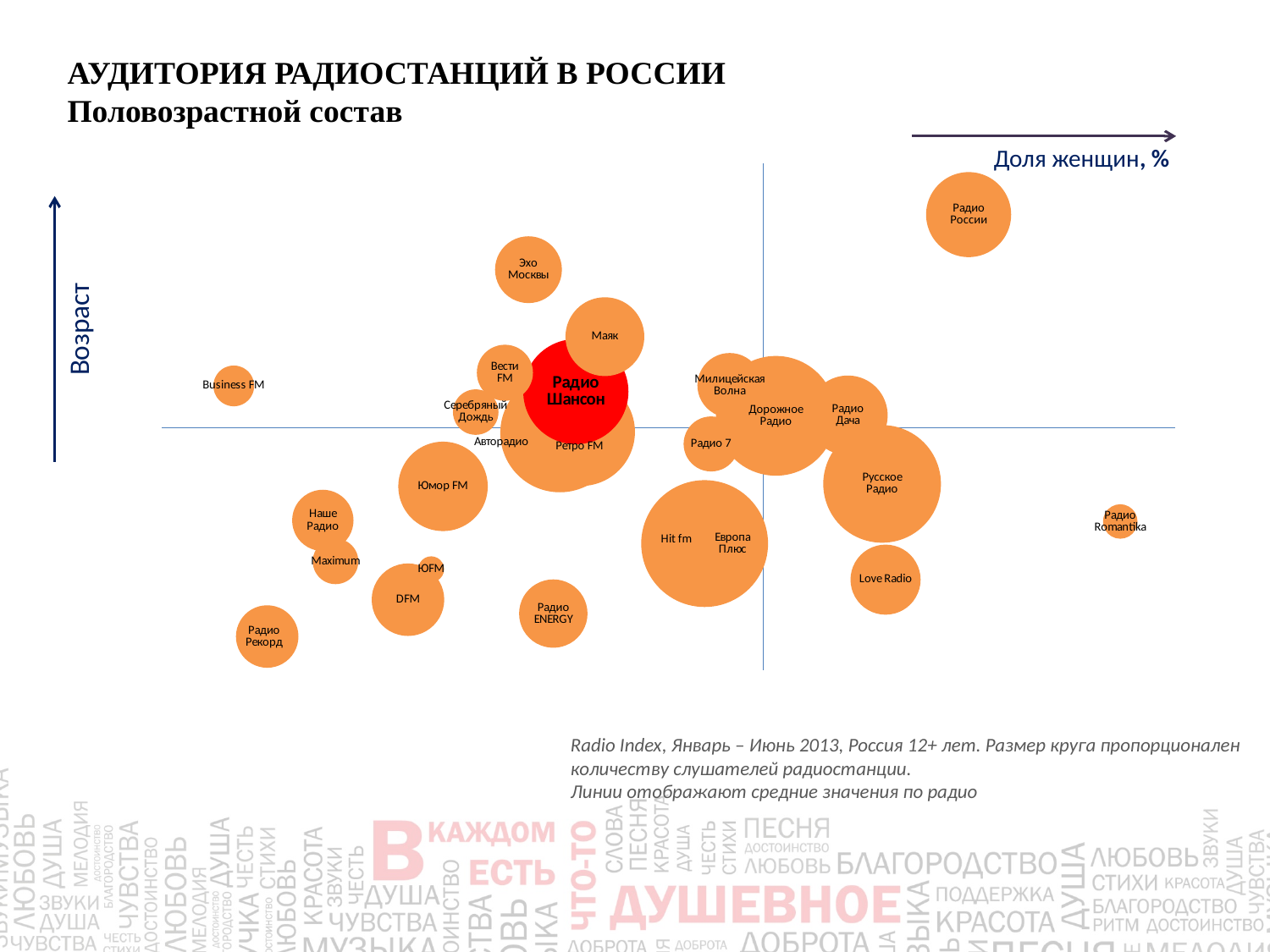
What kind of chart is shown on the slide? Bubble chart Which radio station's bubble is positioned highest on the age (Возраст) axis? Радио России Which radio station's bubble is furthest to the left on the share-of-women (Доля женщин, %) axis? Business FM Which radio station's bubble is furthest to the right on the share-of-women (Доля женщин, %) axis? Радио Romantika Which radio station is highlighted with a red bubble on the chart? Радио Шансон Which station has the higher share of women according to the chart, Русское Радио or Наше Радио? Русское Радио What does the horizontal axis of the chart represent? Доля женщин, % Which radio station's bubble is positioned lowest on the age (Возраст) axis? Радио Рекорд Which station has the older audience according to the chart, Радио России or Love Radio? Радио России Which station has the older audience according to the chart, Эхо Москвы or DFM? Эхо Москвы